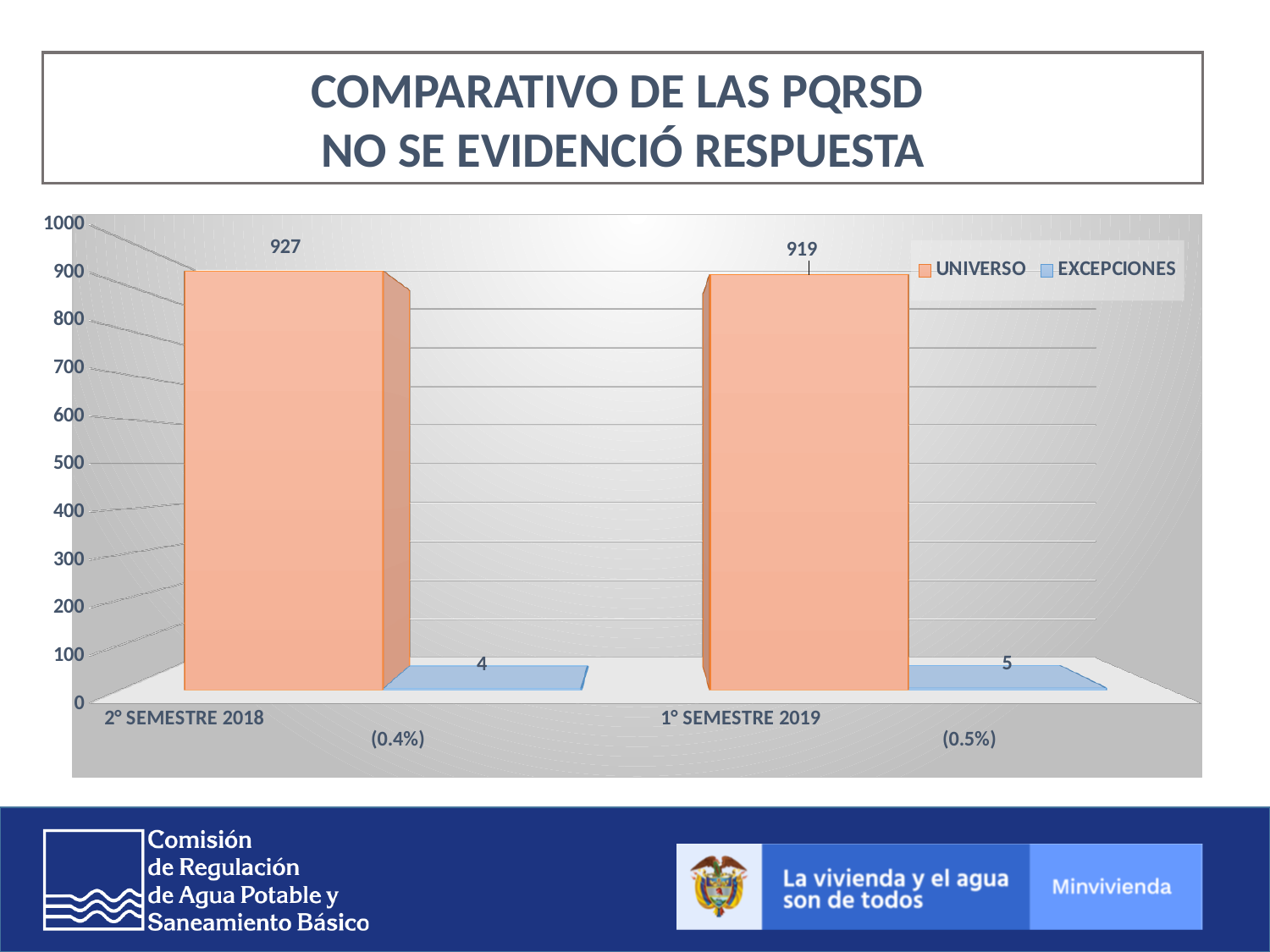
How many categories are shown on the x axis? 2 What is the difference between the UNIVERSO values for 2° SEMESTRE 2018 and 1° SEMESTRE 2019? 8 What is the UNIVERSO value for 2° SEMESTRE 2018? 927 What is the UNIVERSO value for 1° SEMESTRE 2019? 919 Which semester has the higher EXCEPCIONES value? 1° SEMESTRE 2019 What kind of chart is shown on the slide? Bar chart How many series does the legend list? 2 What is the EXCEPCIONES value for 1° SEMESTRE 2019? 5 What is the EXCEPCIONES value for 2° SEMESTRE 2018? 4 What percentage is printed below the 1° SEMESTRE 2019 category? (0.5%) Does the UNIVERSO value rise or fall from 2° SEMESTRE 2018 to 1° SEMESTRE 2019? Fall Is the UNIVERSO value for 1° SEMESTRE 2019 greater or less than 900? greater